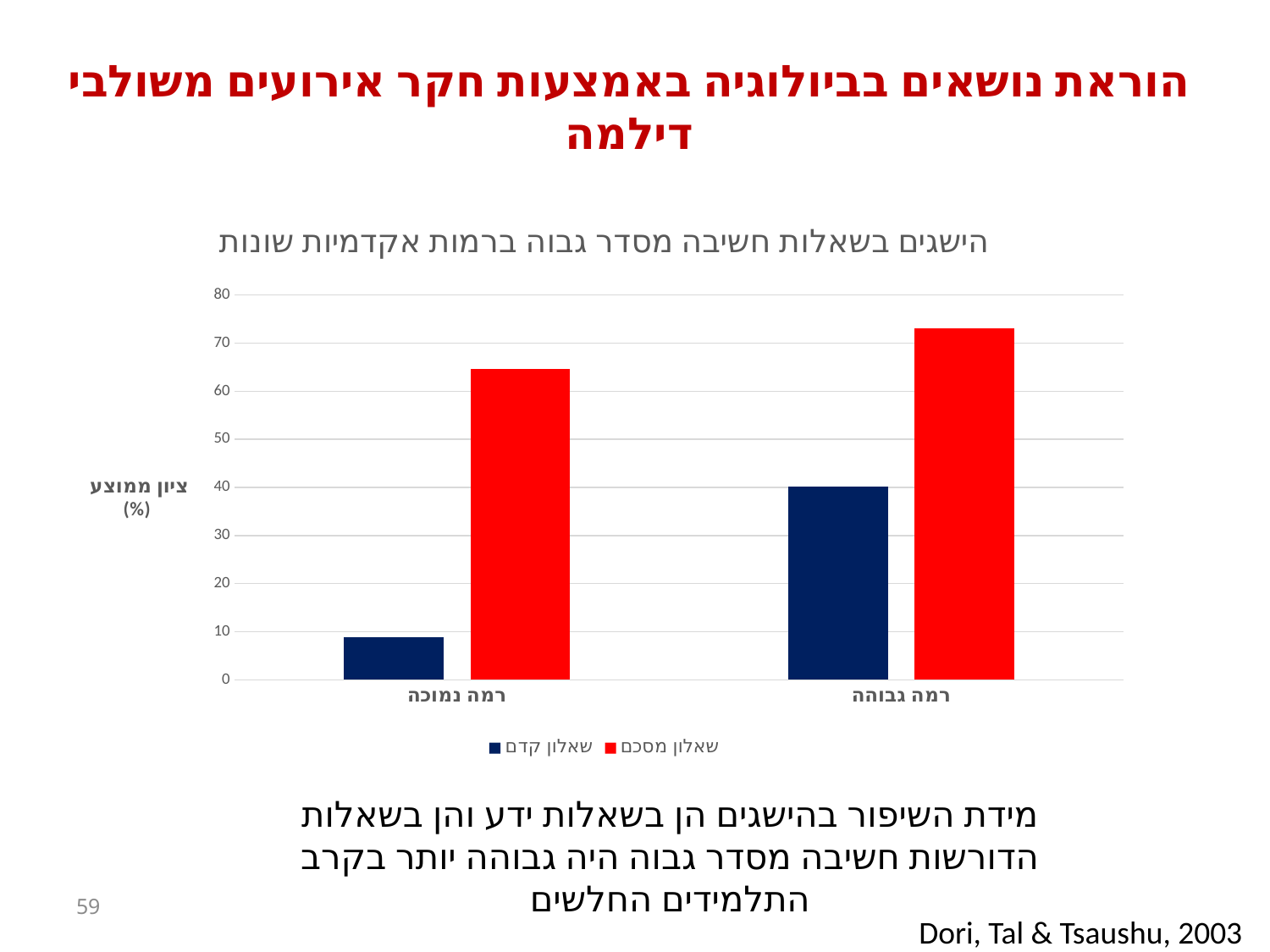
Which category has the lowest שאלון קדם value? רמה נמוכה For רמה נמוכה, which is larger: שאלון קדם or שאלון מסכם? שאלון מסכם Is the value of שאלון מסכם for רמה נמוכה greater or less than 60? greater What is the label on the vertical axis of the chart? ציון ממוצע (%) How many categories are shown on the x axis of the chart? 2 What is the title of the chart? הישגים בשאלות חשיבה מסדר גבוה ברמות אקדמיות שונות How many series does the chart legend list? 2 Is the value of שאלון קדם for רמה נמוכה greater or less than 10? less Which category has the highest שאלון מסכם value? רמה גבוהה Is the value of שאלון קדם for רמה גבוהה greater or less than 30? greater What kind of chart is shown on the slide? bar chart